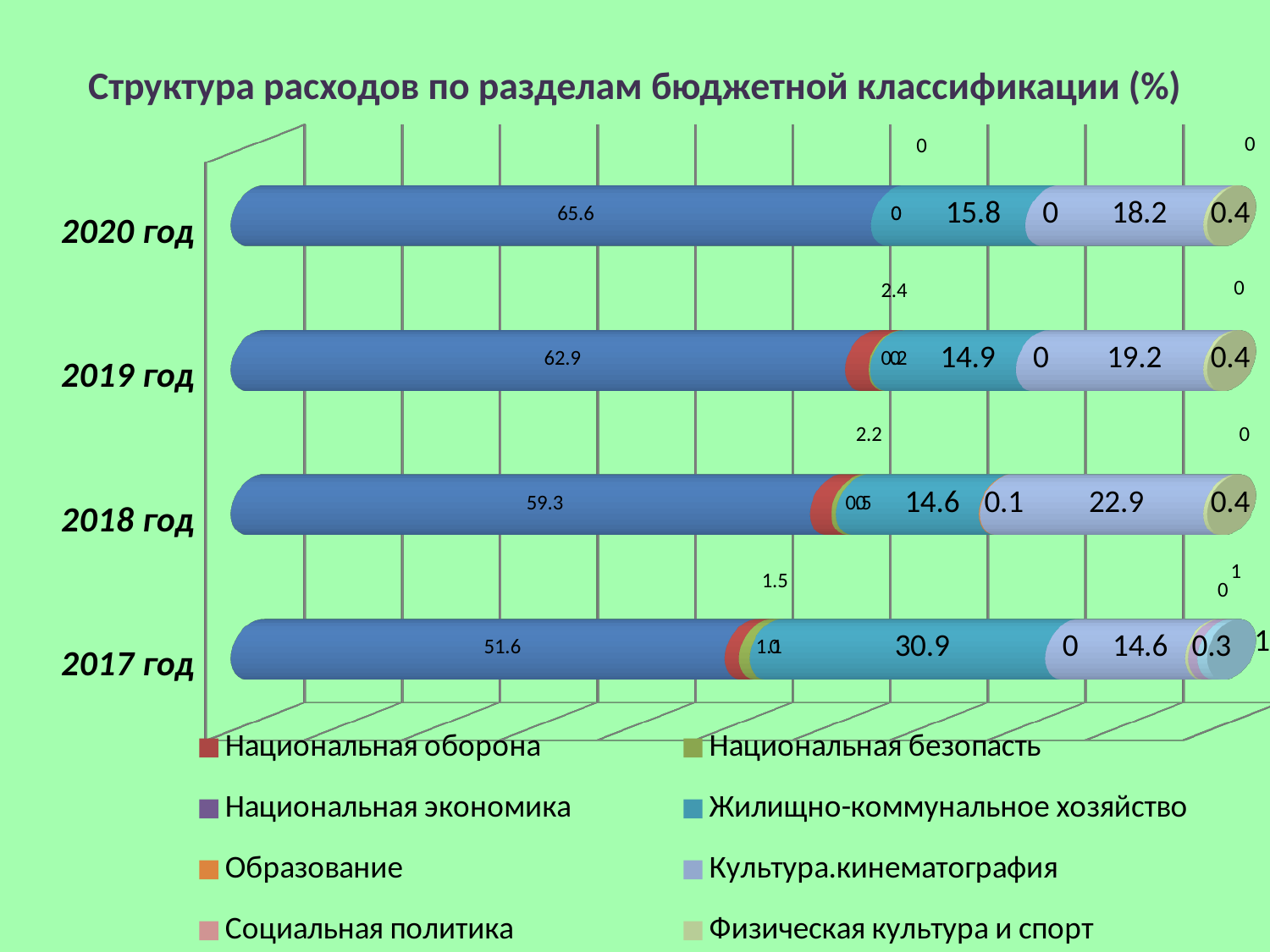
What is the value for Жилищно-коммунальное хозяйство in 2017 год? 30.9 What is the value for Культура.кинематография in 2019 год? 19.2 Which year has the larger value for Культура.кинематография, 2018 год or 2020 год? 2018 год How many years (categories) are plotted on the chart? 4 What is the difference between the leftmost segment values for 2020 год (65.6) and 2019 год (62.9)? 2.7 What is the value of the leftmost (largest) segment of the 2020 год bar? 65.6 Which year has the highest value for the leftmost (largest) segment? 2020 год What is the value of the leftmost (largest) segment of the 2017 год bar? 51.6 How many series does the legend list? 8 What is the title of the chart? Структура расходов по разделам бюджетной классификации (%) Does the value of the leftmost (largest) segment rise or fall from 2017 год to 2020 год? rise What kind of chart is shown on the slide? bar chart